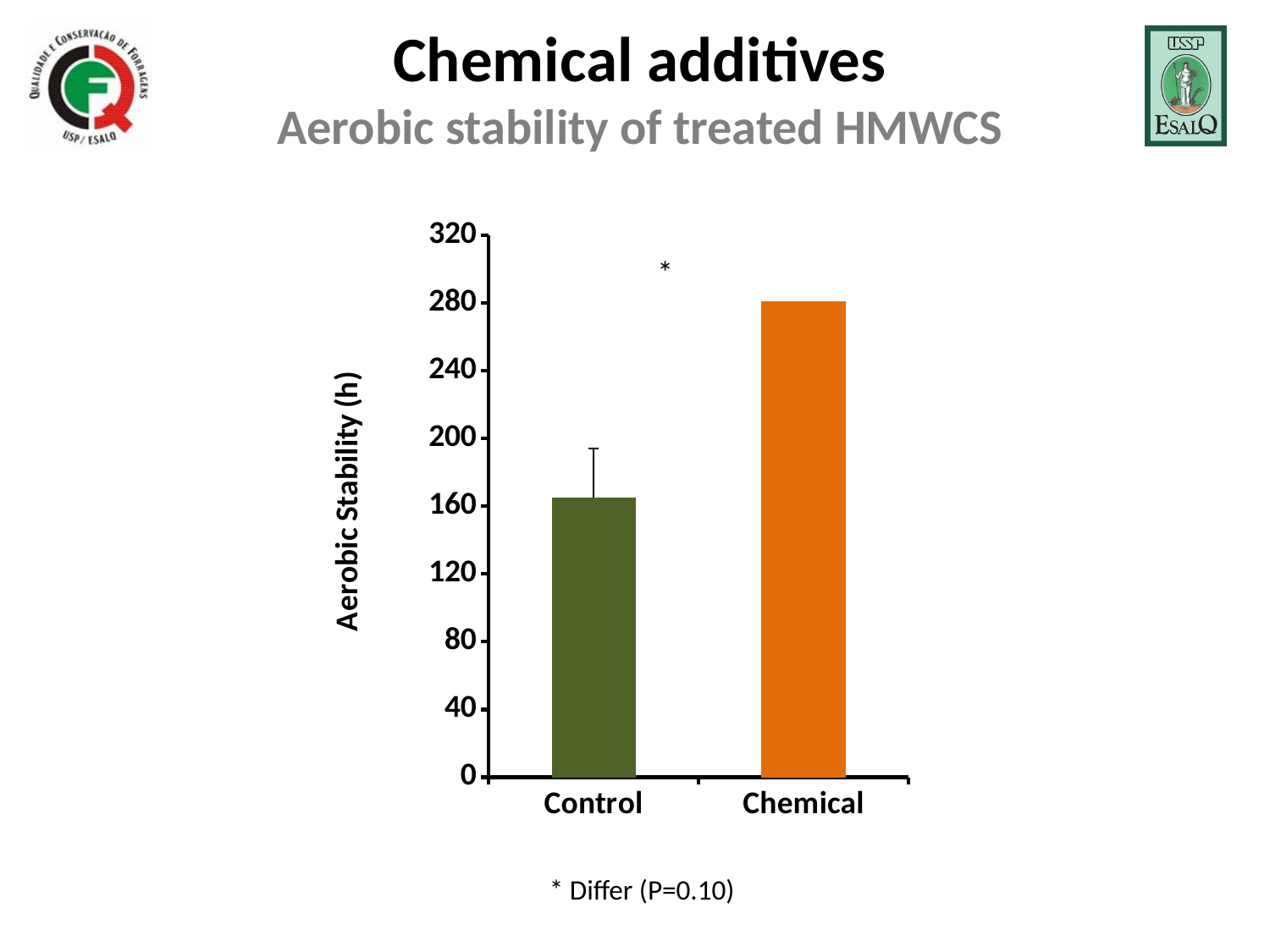
Is the value for Chemical greater or less than 320? less What is the label of the y axis of the chart? Aerobic Stability (h) What kind of chart is shown on the slide? bar chart Is the value for Chemical greater or less than 240? greater Which category has the lowest aerobic stability in the chart? Control Which category has the highest aerobic stability in the chart? Chemical Which bar is taller, Control or Chemical? Chemical Is the value for Control greater or less than 120? greater What colour is the Chemical bar in the chart? orange How many categories are plotted on the x axis of the chart? 2